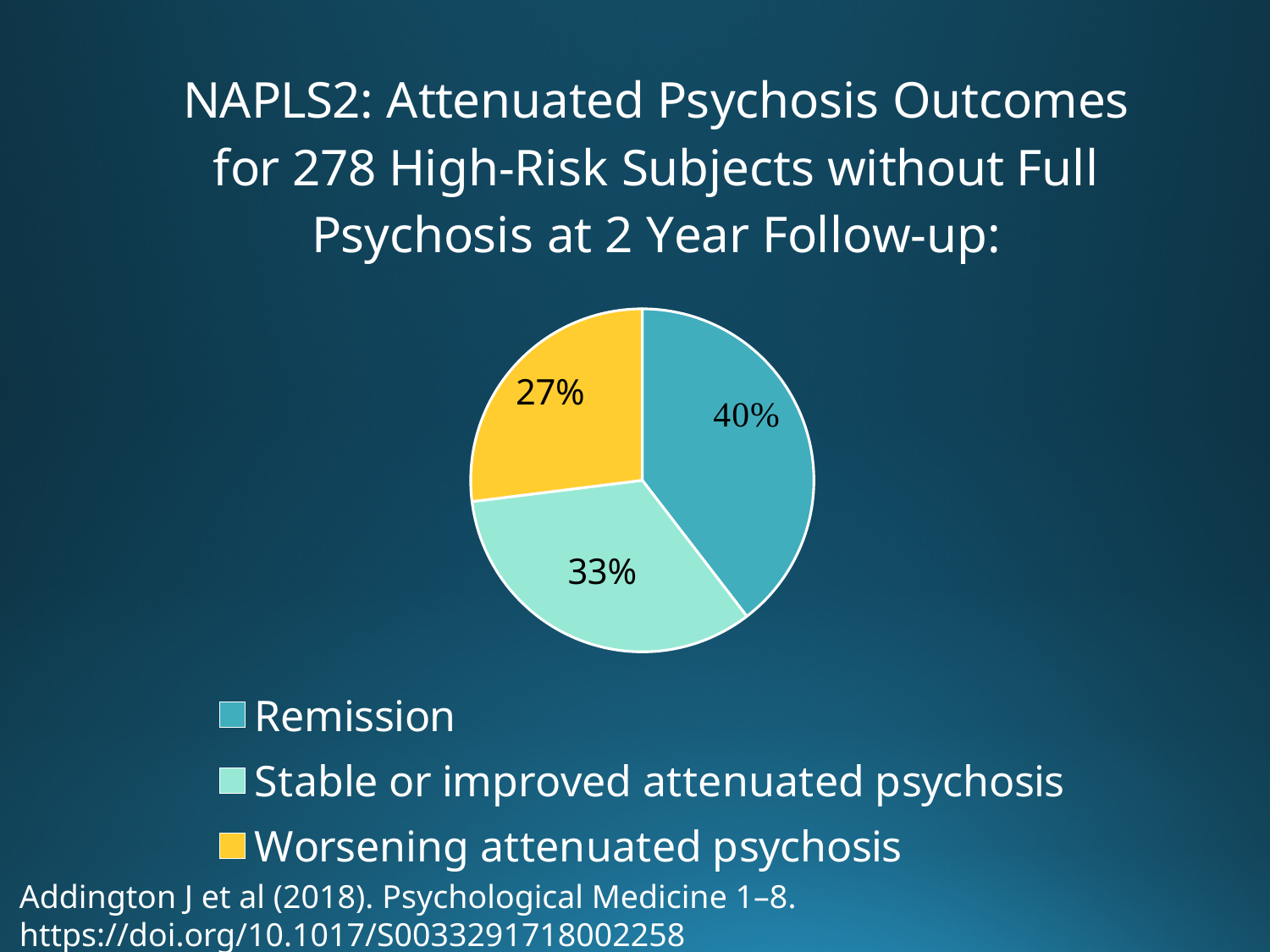
What is the difference in percentage points between Remission and Worsening attenuated psychosis? 13 Which outcome category has the largest share of the pie? Remission What kind of chart is shown on the slide? Pie chart How many subjects does the chart title say the outcomes are for? 278 What colour represents Worsening attenuated psychosis in the pie chart? Yellow What is the difference in percentage points between Stable or improved attenuated psychosis and Worsening attenuated psychosis? 6 Which is larger: the share for Remission or the share for Stable or improved attenuated psychosis? Remission Which outcome category has the smallest share of the pie? Worsening attenuated psychosis What percentage of subjects had worsening attenuated psychosis? 27% What percentage of subjects were in remission? 40% How many categories does the pie chart show? 3 What percentage of subjects had stable or improved attenuated psychosis? 33%